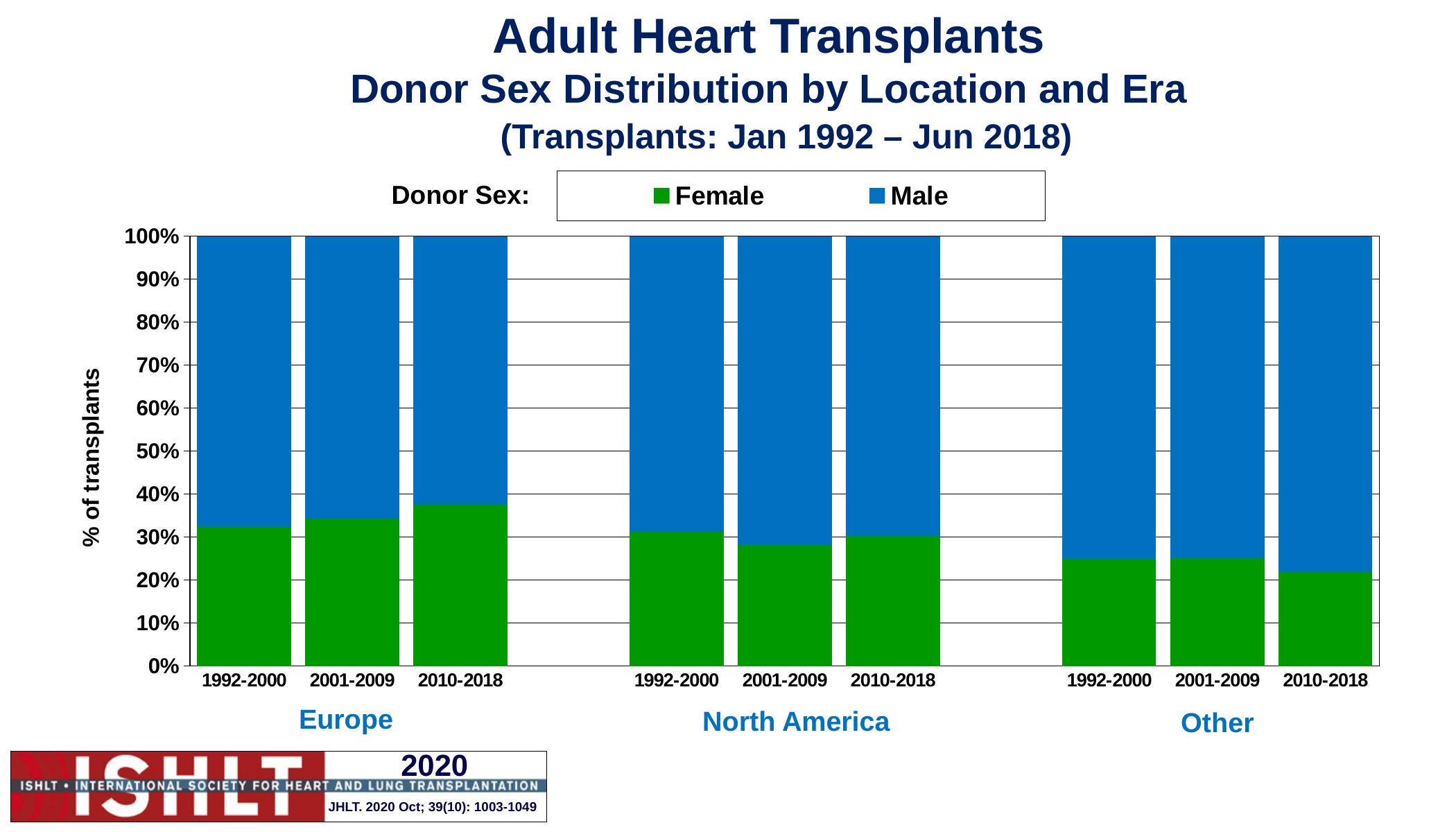
What kind of chart is shown on the slide? Stacked bar chart Which location and era has the highest Female share? Europe, 2010-2018 Is the Female share for Other in 2010-2018 greater or less than 30%? less Is the Female share for North America in 2001-2009 greater or less than 20%? greater Which location and era has the lowest Female share? Other, 2010-2018 Which has the larger Male share in 2010-2018, Europe or Other? Other How many bars are plotted in the chart? 9 How many series does the legend list? 2 Which colour represents Male donors in the chart? Blue Is the Female share for Europe in 2010-2018 greater or less than 30%? greater Does the Female share for Europe rise or fall across the three eras? rise How many locations are shown along the x axis? 3